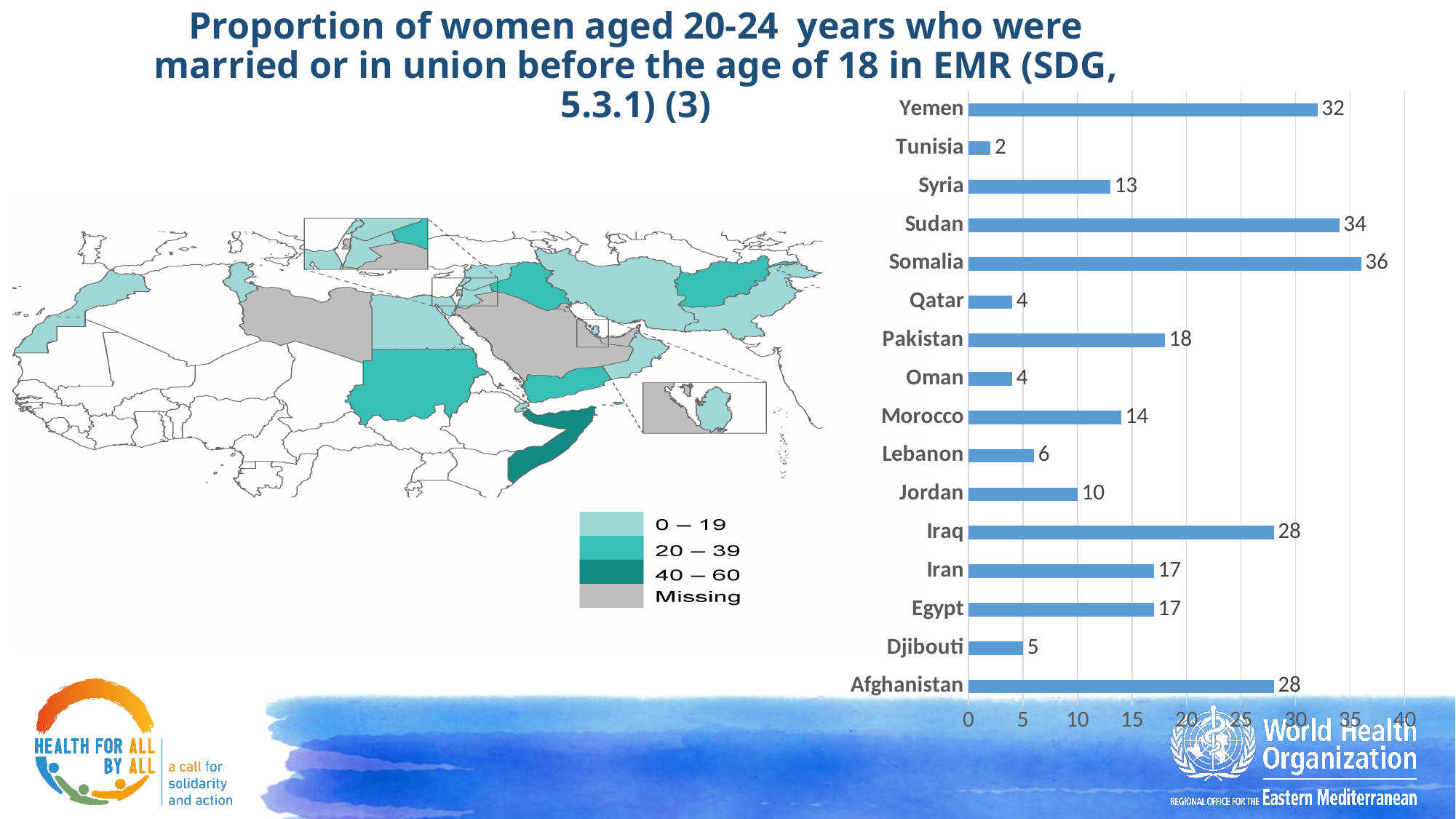
What is the title of the slide's chart? Proportion of women aged 20-24 years who were married or in union before the age of 18 in EMR (SDG, 5.3.1) (3) Which country has the lowest value in the bar chart? Tunisia Which has a larger value in the bar chart, Morocco or Lebanon? Morocco What is the value shown for Pakistan in the bar chart? 18 What is the value shown for Jordan in the bar chart? 10 How many countries are shown in the bar chart? 16 Is the value for Afghanistan in the bar chart greater or less than 25? greater What is the value shown for Somalia in the bar chart? 36 Which country has the highest value in the bar chart? Somalia What is the difference between the values for Yemen and Iraq in the bar chart? 4 What is the difference between the values for Sudan and Syria in the bar chart? 21 What kind of chart is used to show the values by country? bar chart